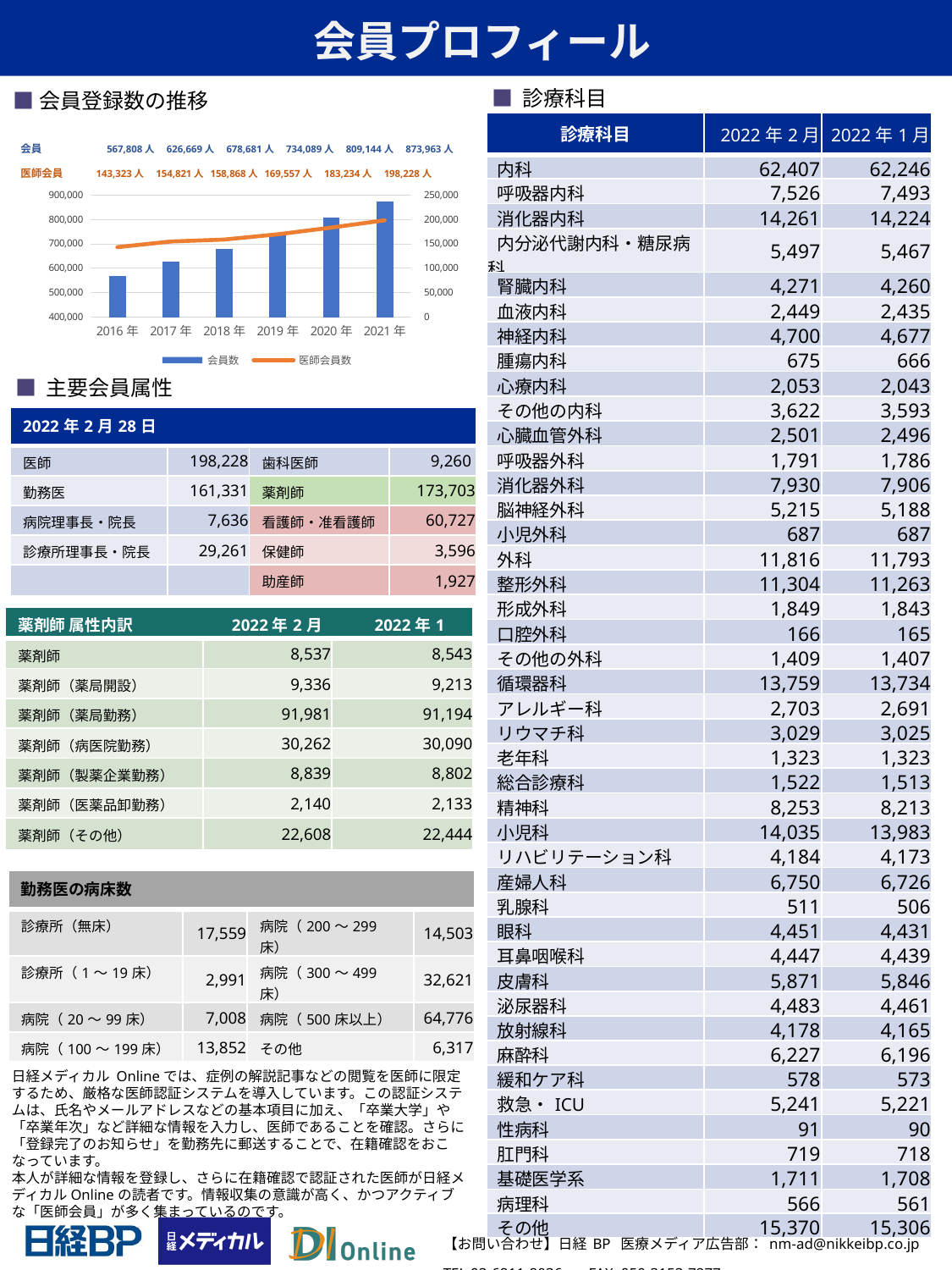
In the 会員登録数の推移 chart, how many series does the legend list? 2 In the 会員登録数の推移 chart, which year has the lowest 医師会員 value? 2016年 In the 会員登録数の推移 chart, which series is drawn as an orange line? 医師会員数 In the 会員登録数の推移 chart, what is the 会員 value for 2021年? 873,963人 In the 会員登録数の推移 chart, how many years are shown on the x axis? 6 What kind of chart is used in the 会員登録数の推移 section? Combined bar and line chart In the 会員登録数の推移 chart, which year has the highest 会員 value? 2021年 In the 会員登録数の推移 chart, what is the 医師会員 value for 2020年? 183,234人 In the 会員登録数の推移 chart, what is the 医師会員 value for 2016年? 143,323人 In the 会員登録数の推移 chart, do the 会員数 values rise or fall from 2016年 to 2021年? Rise In the 会員登録数の推移 chart, what is the difference between the 会員 values for 2021年 and 2020年? 64,819人 In the 会員登録数の推移 chart, what is the 会員 value for 2018年? 678,681人